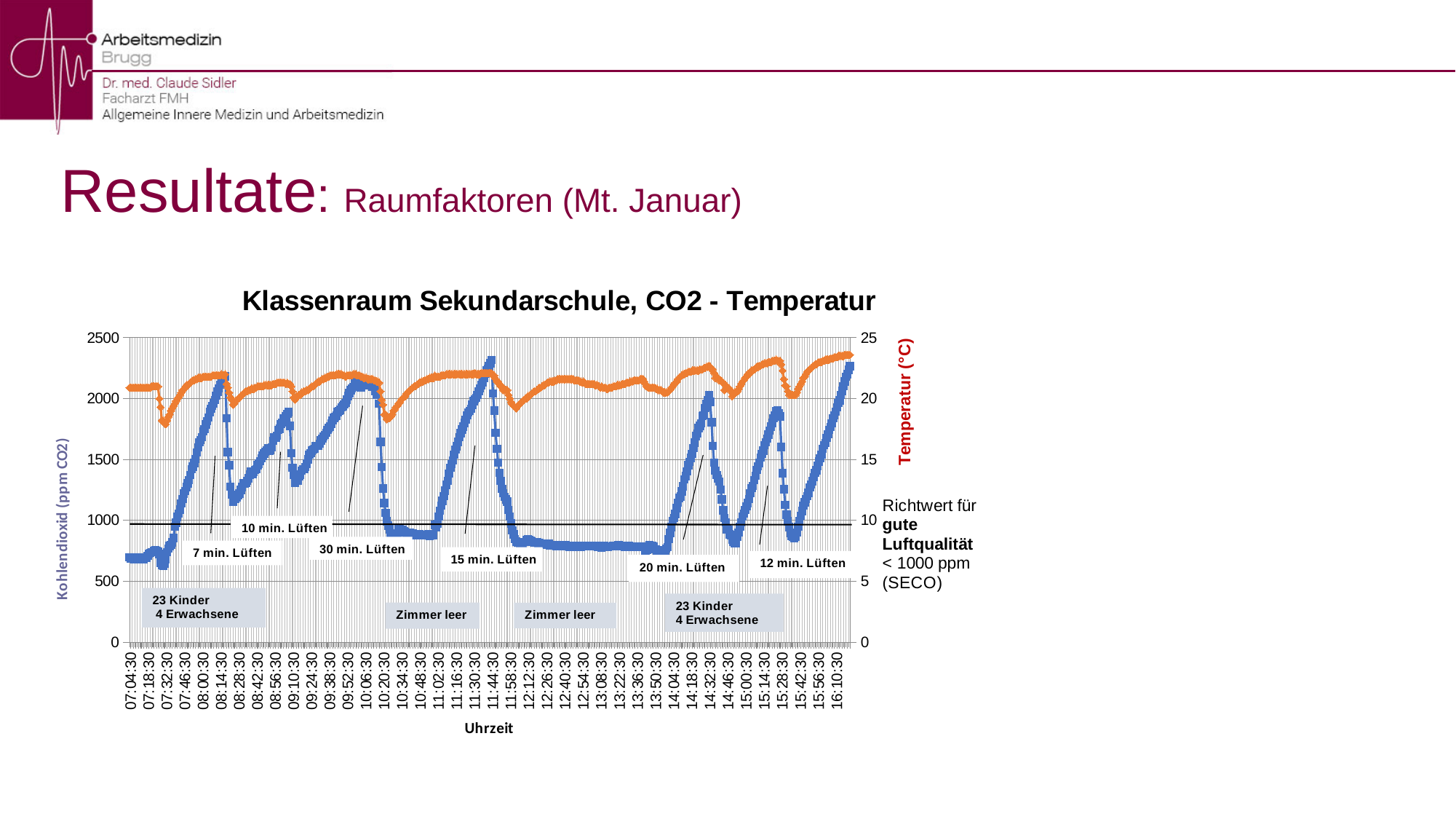
What is the maximum value shown on the right temperature axis? 25 What is the label of the left vertical axis? Kohlendioxid (ppm CO2) Does the CO2 value rise or fall between 07:32:30 and 08:14:30? rise Is the CO2 value at 11:44:30 greater or less than 2000 ppm? greater Is the CO2 value at 12:40:30 greater or less than 1000 ppm? less Does the CO2 value rise or fall between 11:44:30 and 11:58:30? fall What kind of chart is shown on the slide? line chart What is the title of the chart? Klassenraum Sekundarschule, CO2 - Temperatur Is the temperature at 07:04:30 greater or less than 20 °C? greater How many 'Lüften' (ventilation) annotations are shown on the chart? 6 Which is higher, the CO2 peak at about 11:44:30 or the CO2 peak at about 14:32:30? 11:44:30